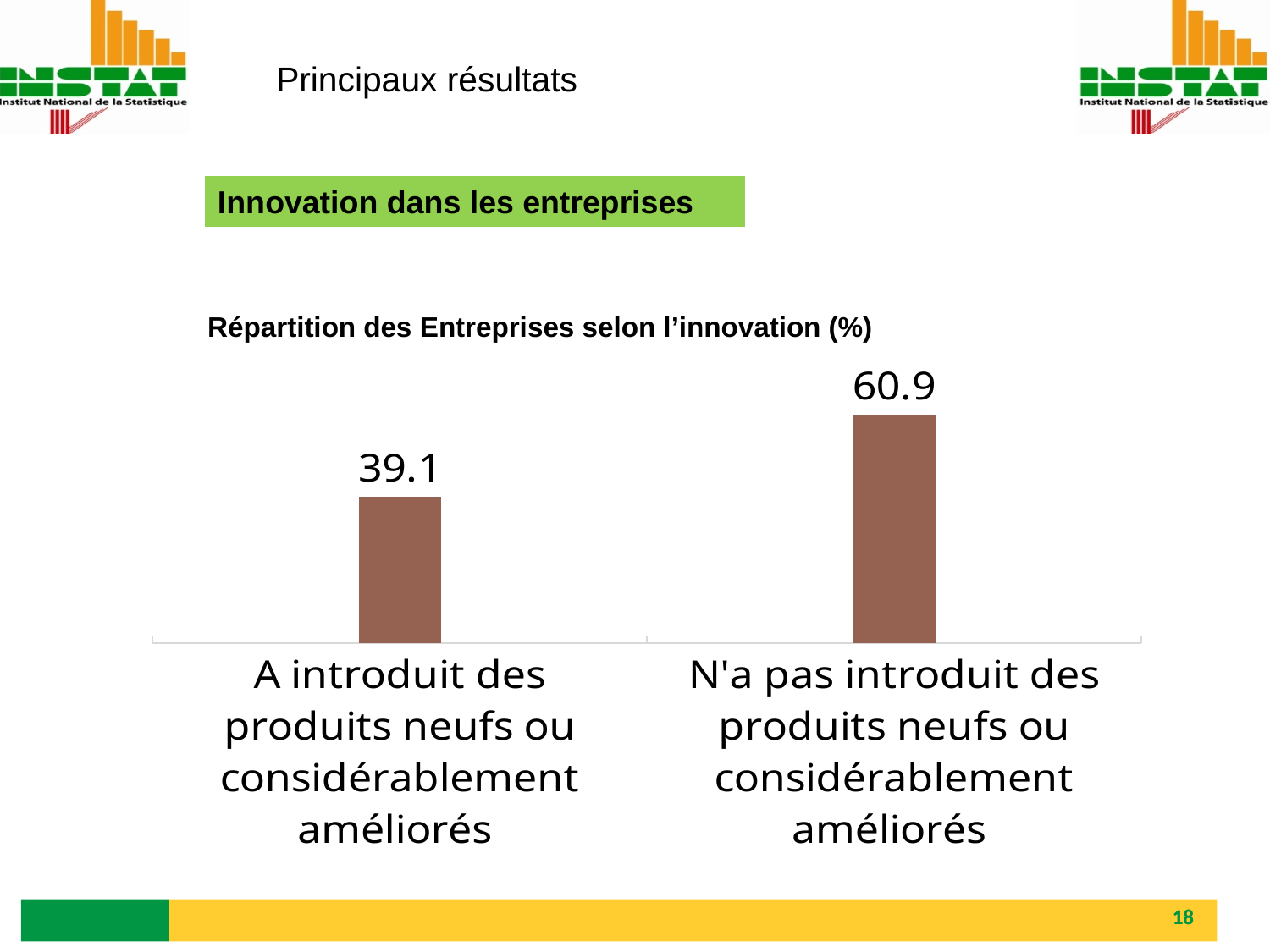
What is the title of the chart? Répartition des Entreprises selon l'innovation (%) What is the difference between the values for 'N'a pas introduit' and 'A introduit' des produits neufs ou considérablement améliorés? 21.8 Which category has the lowest value? A introduit des produits neufs ou considérablement améliorés Which category has the highest value? N'a pas introduit des produits neufs ou considérablement améliorés What is the total of the two values shown in the chart? 100 What is the value for 'A introduit des produits neufs ou considérablement améliorés'? 39.1 What colour are the bars in the chart? Brown How many categories are shown in the chart? 2 Which is larger: the value for 'A introduit des produits neufs ou considérablement améliorés' or for 'N'a pas introduit des produits neufs ou considérablement améliorés'? N'a pas introduit des produits neufs ou considérablement améliorés What kind of chart is shown on the slide? Bar chart What is the value for 'N'a pas introduit des produits neufs ou considérablement améliorés'? 60.9